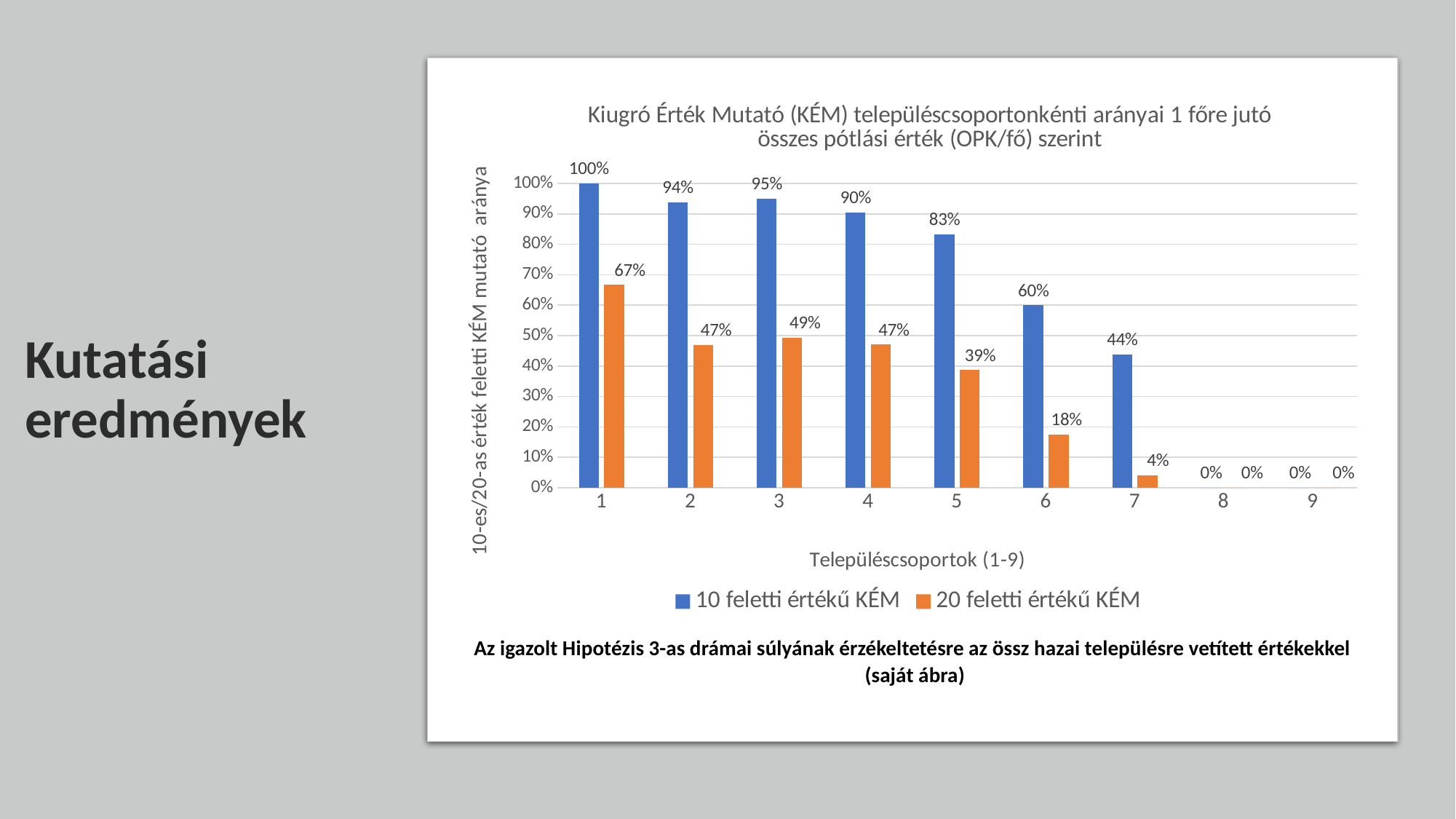
What is the value of the "20 feletti értékű KÉM" series for településcsoport 3? 49% What is the difference between the "10 feletti értékű KÉM" and "20 feletti értékű KÉM" values for településcsoport 1? 33% What is the difference between the "10 feletti értékű KÉM" values for településcsoport 6 and településcsoport 7? 16% What is the value of the "10 feletti értékű KÉM" series for településcsoport 5? 83% What is the value of the "20 feletti értékű KÉM" series for településcsoport 7? 4% What kind of chart is shown on the slide? Bar chart Do the "10 feletti értékű KÉM" values generally rise or fall from településcsoport 1 to 9? Fall How many series does the legend list? 2 Which településcsoport has the highest value in the "10 feletti értékű KÉM" series? 1 Which is larger: the "20 feletti értékű KÉM" value for településcsoport 2 or for településcsoport 5? Településcsoport 2 Which településcsoport has the lowest non-zero value in the "20 feletti értékű KÉM" series? 7 How many településcsoport categories are shown on the x axis? 9